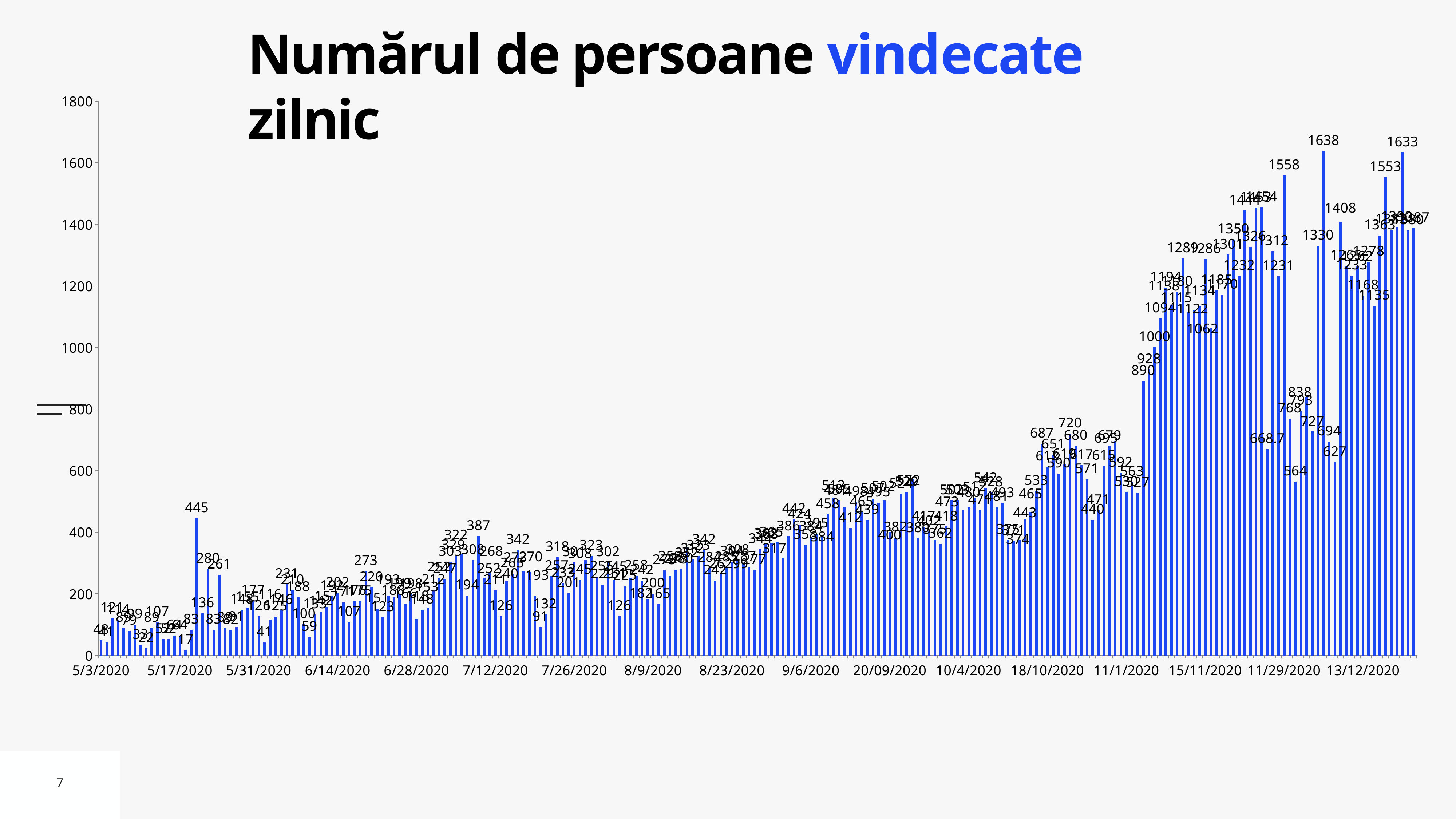
Is the value for 5/3/2020 greater or less than 200? less What is the lowest daily value shown in the chart? 17 Do the daily values generally rise or fall from May 2020 to December 2020? rise What is the title of the chart? Numărul de persoane vindecate zilnic What is the value of the tallest bar in May 2020? 445 What is the difference between the two highest labelled values, 1638 and 1633? 5 What is the maximum value shown on the vertical axis? 1800 Which is larger, the bar labelled 1638 or the bar labelled 1633? 1638 What kind of chart is shown on the slide? bar chart Is the value for 13/12/2020 greater or less than 1000? greater What is the difference between the highest value, 1638, and the value labelled 1558? 80 What is the highest daily value shown in the chart? 1638